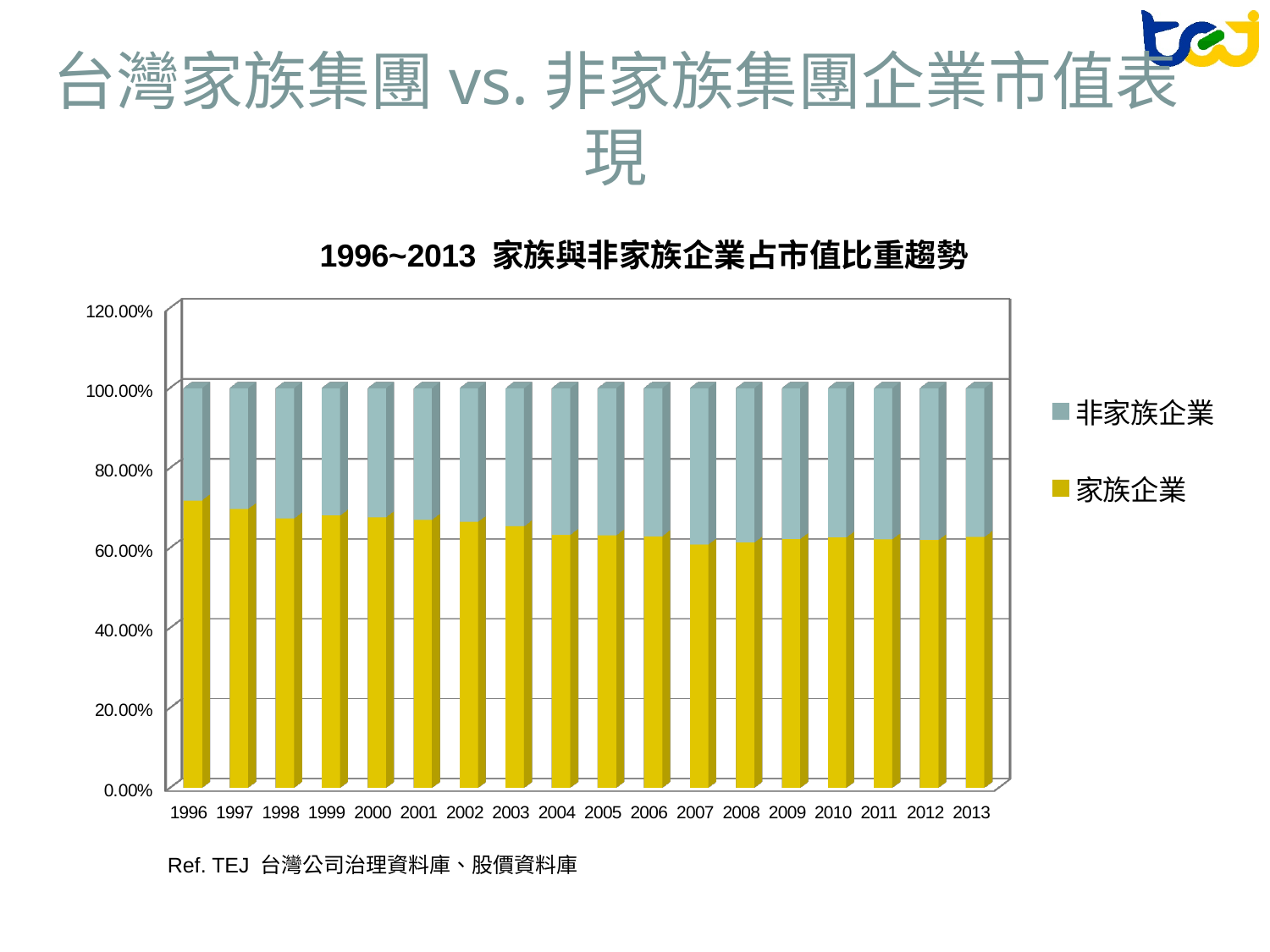
How many series does the legend list? 2 Is the value for 家族企業 in 2013 greater or less than 80.00%? less What is the total height of the stacked bar for 2005? 100.00% In which year is the 家族企業 share the highest? 1996 Does the 家族企業 share rise or fall from 1996 to 2007? fall Which year has the larger 家族企業 share, 1996 or 2013? 1996 What kind of chart is shown on the slide? Stacked bar chart Is the value for 家族企業 in 2007 greater or less than 80.00%? less Is the value for 家族企業 in 1996 greater or less than 60.00%? greater Which series is shown in yellow? 家族企業 How many years (categories) are plotted along the x axis? 18 What is the title of the chart? 1996~2013 家族與非家族企業占市值比重趨勢